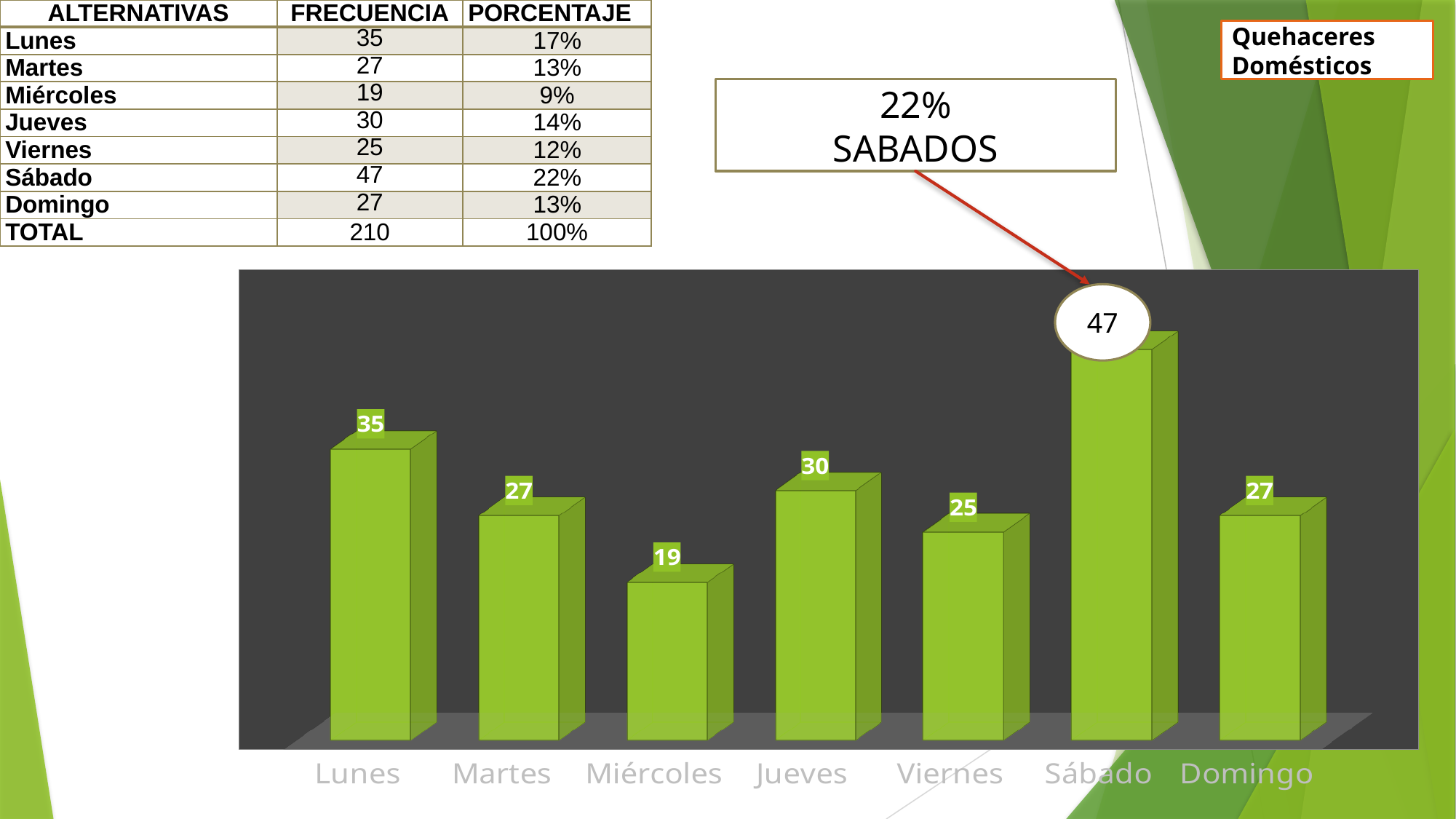
What type of chart is shown on the slide? Bar chart What percentage does the callout box above the chart attribute to Sábados? 22% Which is larger, the value for Jueves or the value for Viernes? Jueves What is the difference between the values for Sábado and Lunes? 12 Which day has the lowest bar? Miércoles What is the value of the bar for Miércoles? 19 What is the difference between the values for Jueves and Miércoles? 11 Which day has the highest bar? Sábado What is the value of the bar for Viernes? 25 How many bars are shown in the chart? 7 What is the value of the bar for Sábado? 47 What is the value of the bar for Lunes? 35